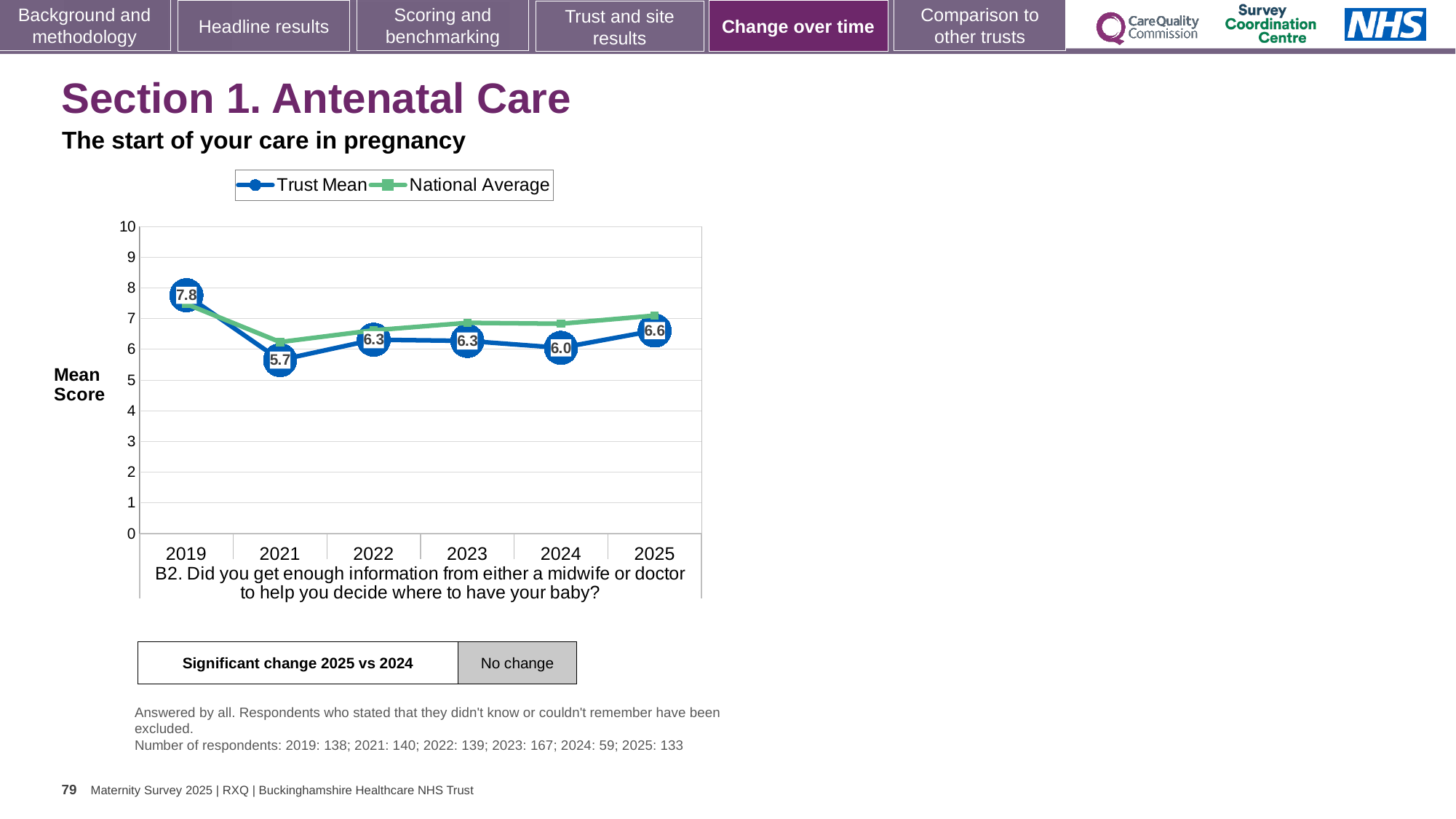
What kind of chart is shown on the slide? Line chart What is the Trust Mean value for 2019? 7.8 What is the difference between the Trust Mean in 2019 and in 2021? 2.1 Which year has the larger Trust Mean, 2024 or 2025? 2025 Is the National Average value for 2021 greater or less than 7? less What is the Trust Mean value for 2025? 6.6 In which year is the Trust Mean lowest? 2021 Does the Trust Mean rise or fall from 2019 to 2021? Fall Is the National Average value for 2019 greater or less than 7? greater How many series does the chart legend list? 2 In which year is the Trust Mean highest? 2019 How many years are shown on the x axis of the chart? 6